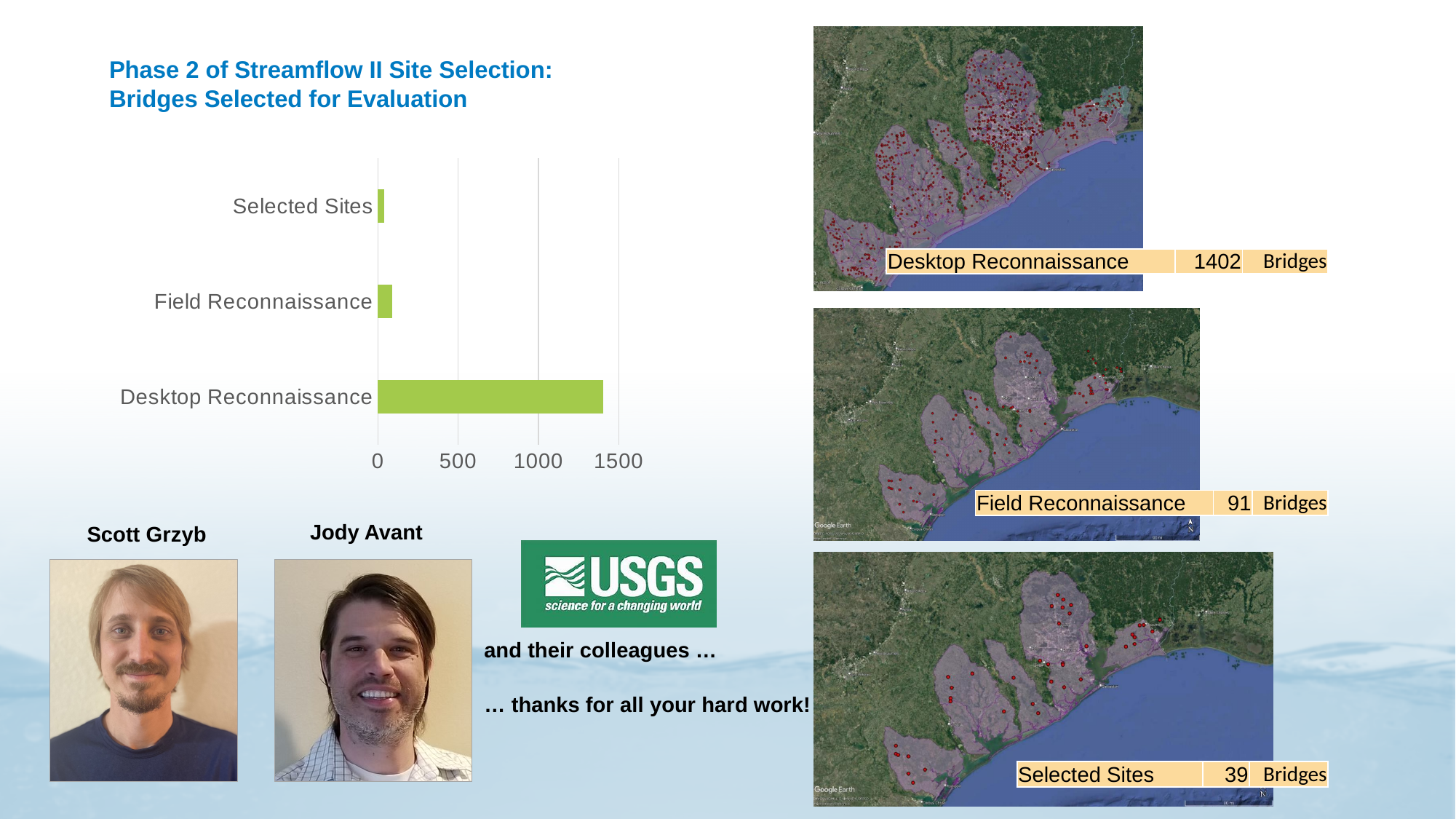
How many bridges does the slide give for Field Reconnaissance? 91 Is the value for Field Reconnaissance greater or less than 500? less What kind of chart is shown on the slide? bar chart What is the difference between the number of bridges for Field Reconnaissance and for Selected Sites? 52 Which category in the bar chart has the highest value? Desktop Reconnaissance How many bridges does the slide give for Selected Sites? 39 What is the highest value shown on the x axis of the bar chart? 1500 Is the value for Desktop Reconnaissance greater or less than 1000? greater Which is larger, the value for Field Reconnaissance or the value for Selected Sites? Field Reconnaissance Which category in the bar chart has the lowest value? Selected Sites How many categories does the bar chart show? 3 How many bridges does the slide give for Desktop Reconnaissance? 1402